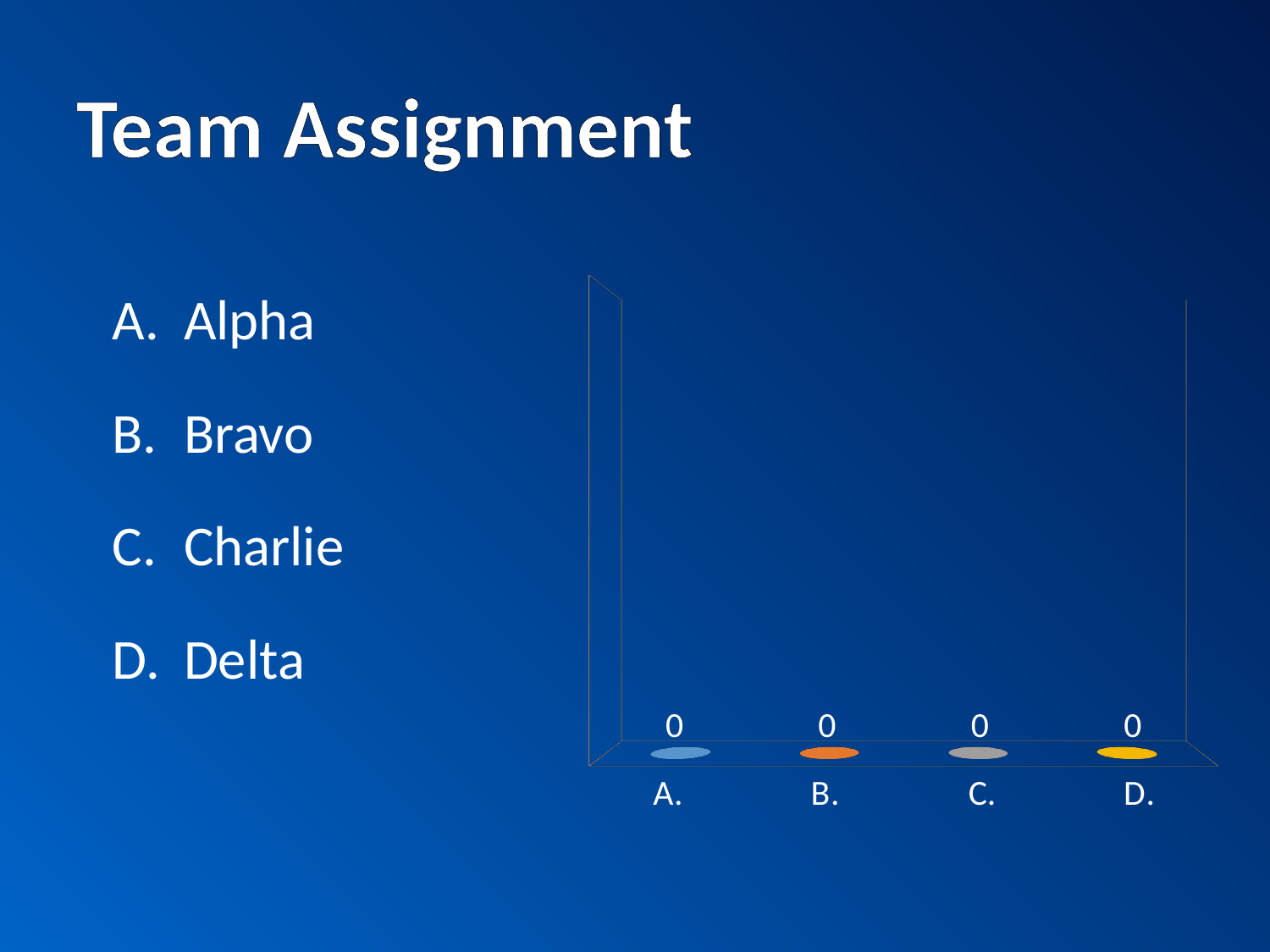
Do the values rise, fall, or stay the same from A. to D.? Stay the same What is the value for category D. in the chart? 0 What is the value for category B. in the chart? 0 What colour is the bar for category B.? Orange What colour is the bar for category D.? Yellow What kind of chart is shown on the slide? Bar chart What is the difference between the values for A. and D.? 0 What is the value for category A. in the chart? 0 What is the difference between the values for B. and C.? 0 What is the value for category C. in the chart? 0 How many categories are shown on the x axis of the chart? 4